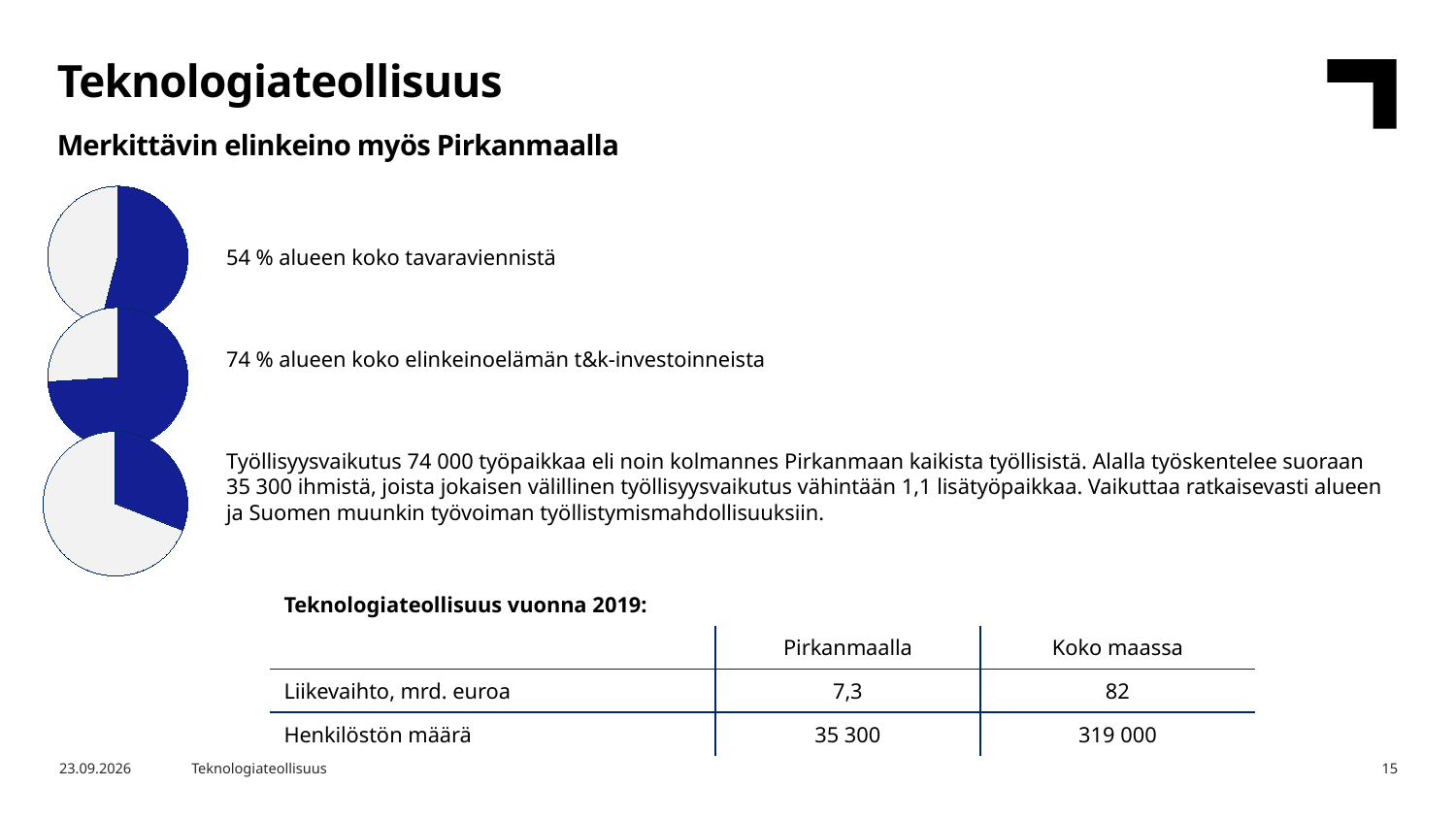
What share of the region's total goods exports does the top pie chart represent, according to the text next to it? 54 % Is the highlighted (blue) slice of the bottom pie chart greater or less than 50 % of the pie? less Which pie chart has the larger highlighted (blue) slice, the top one or the middle one? the middle one What colour is the highlighted slice in each pie chart? blue What is the difference in percentage points between the shares shown for the middle pie chart (74 %) and the top pie chart (54 %)? 20 percentage points Which of the three pie charts has the smallest highlighted (blue) slice? the bottom one How many slices does each pie chart have? 2 What kind of chart are the three charts on the left side of the slide? pie chart What share of the region's business R&D investments does the middle pie chart represent, according to the text next to it? 74 % Which of the three pie charts has the largest highlighted (blue) slice? the middle one How many pie charts are shown on the slide? 3 Is the highlighted (blue) slice of the middle pie chart greater or less than 50 % of the pie? greater